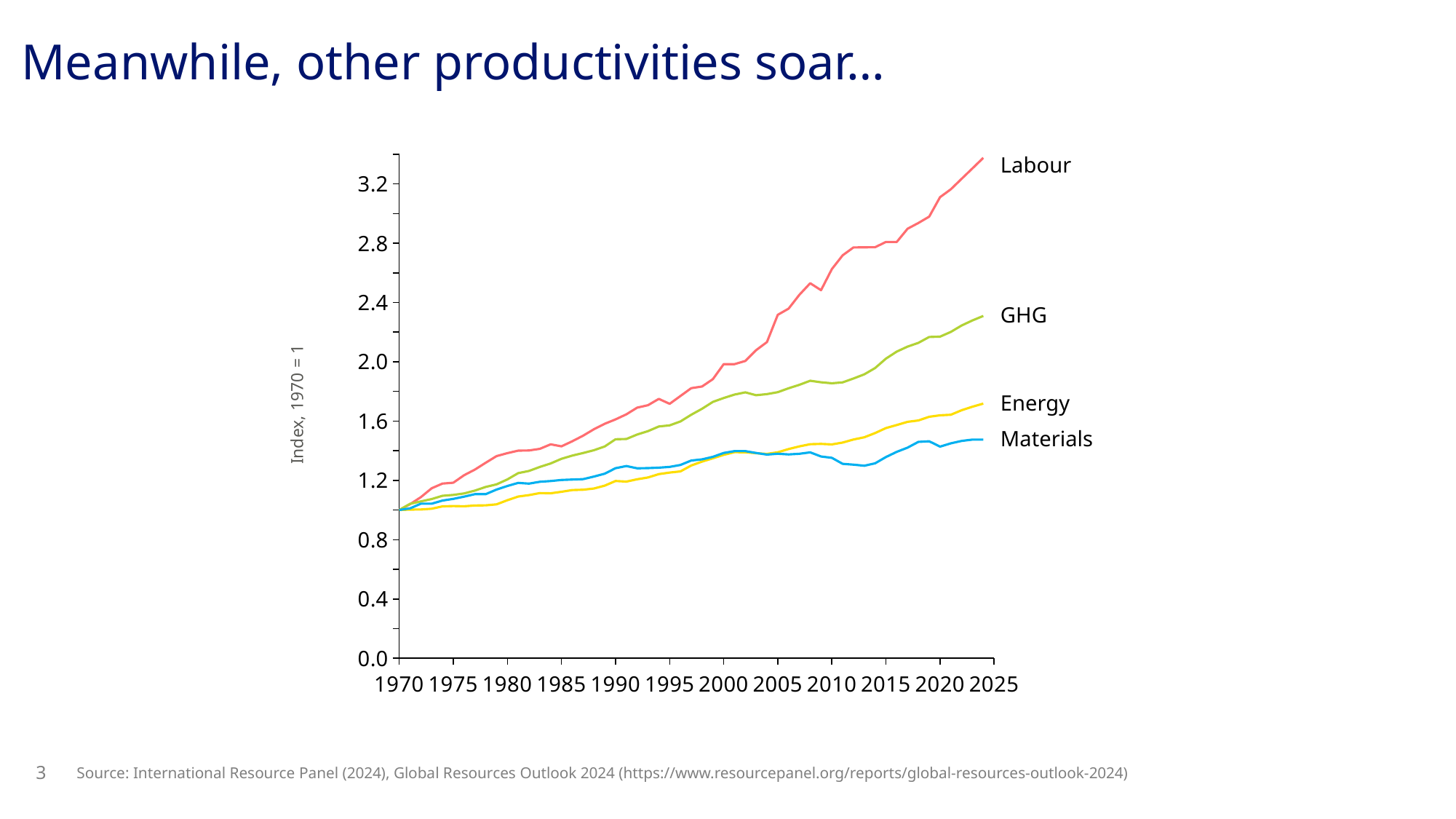
What is the label on the vertical axis? Index, 1970 = 1 How many series are plotted on the chart? 4 Is the value for Labour at the end of the period greater or less than 2.8? greater Does the Labour series rise or fall from 1970 to 2024? Rise At the end of the period, which is larger: Energy or Materials? Energy Which series has the highest value at the end of the period (around 2024)? Labour What is the index value of all four series in 1970? 1 Is the value for Materials at the end of the period greater or less than 1.6? less Is the value for GHG at the end of the period greater or less than 2.0? greater What kind of chart is shown on the slide? Line chart Which series has the lowest value at the end of the period (around 2024)? Materials